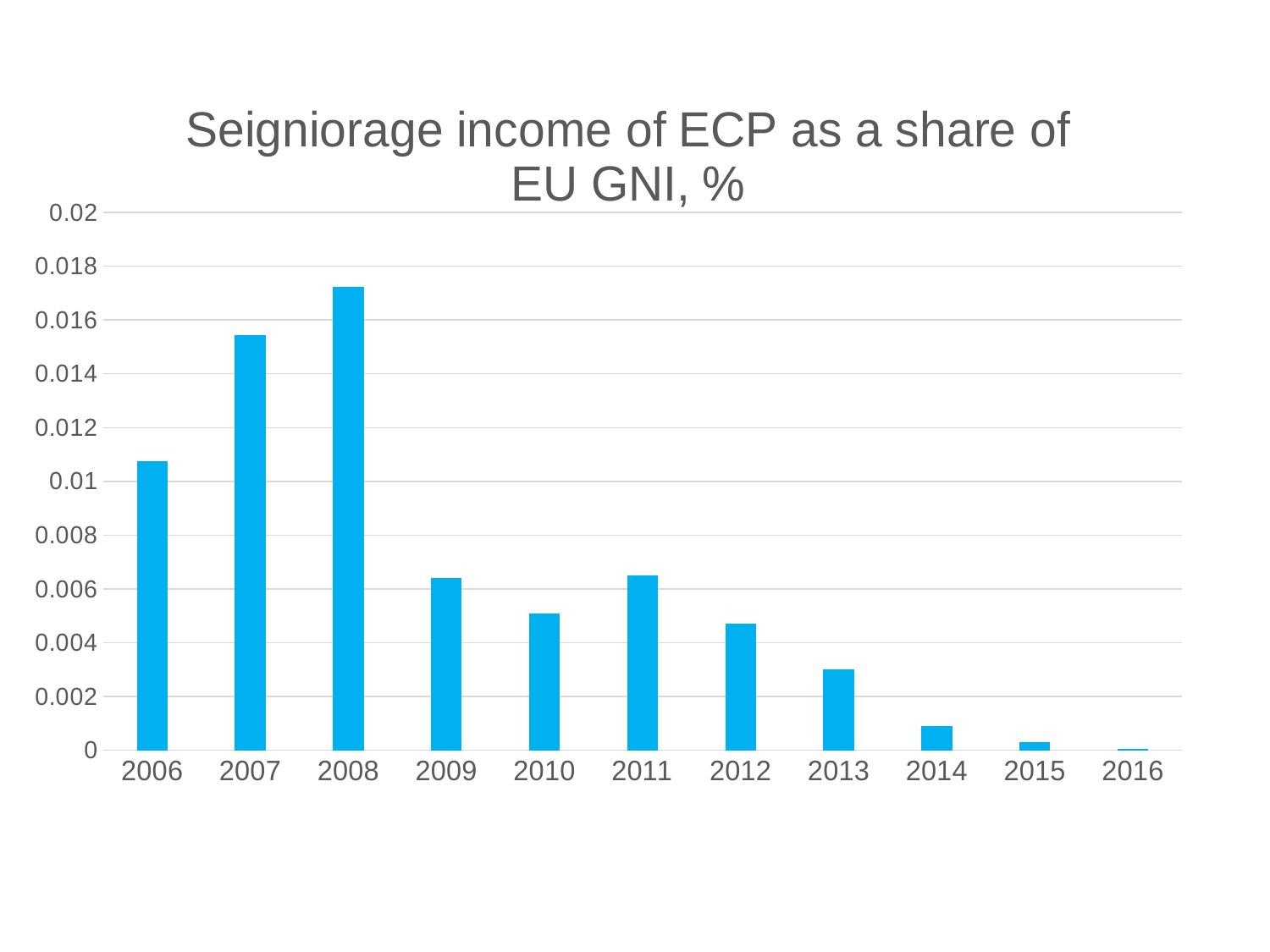
What kind of chart is shown on the slide? bar chart Is the value for 2006 greater or less than 0.01? greater How many years are shown on the x axis of the chart? 11 Is the value for 2014 greater or less than 0.002? less What is the title of the chart? Seigniorage income of ECP as a share of EU GNI, % Is the value for 2009 greater or less than 0.008? less Which year has the highest seigniorage income as a share of EU GNI? 2008 Overall, do the values rise or fall from 2008 to 2016? fall Which year has the larger value, 2007 or 2009? 2007 Which year has the lowest seigniorage income as a share of EU GNI? 2016